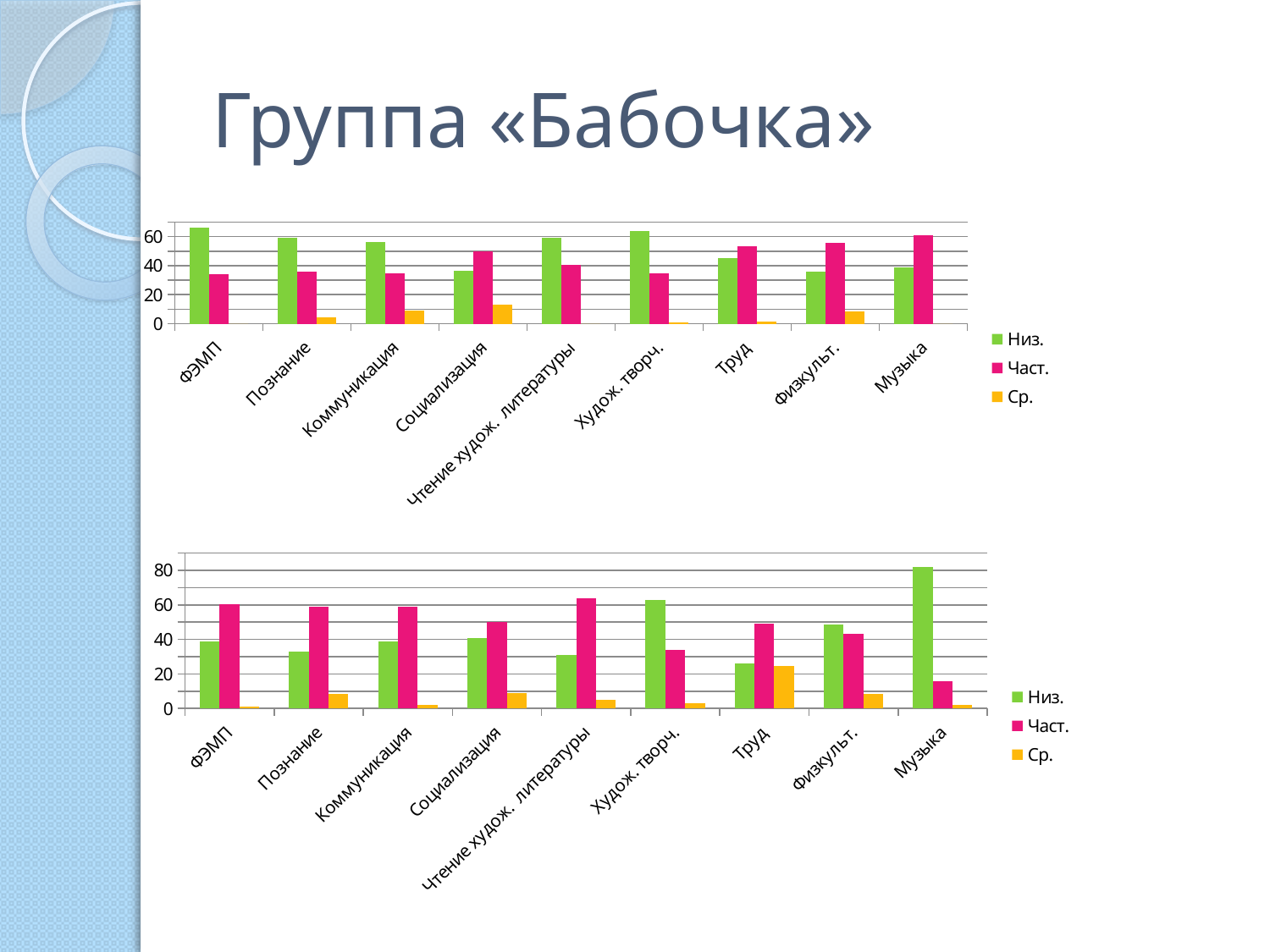
In the top chart, is the value of Низ. for Социализация greater or less than 40? less How many categories are shown on the x axis of the top chart? 9 In the bottom chart, which category has the lowest Низ. value? Труд In the bottom chart, which is larger for ФЭМП: Низ. or Част.? Част. What kind of chart is the top chart on the slide? bar chart In the top chart, which category has the highest Ср. value? Социализация What colour are the Ср. bars in both charts? orange In the top chart, is the value of Низ. for ФЭМП greater or less than 60? greater In the bottom chart, which category has the highest Низ. value? Музыка In the bottom chart, is the value of Част. for Музыка greater or less than 20? less In the top chart, which category has the highest Част. value? Музыка How many series does the legend of the bottom chart list? 3